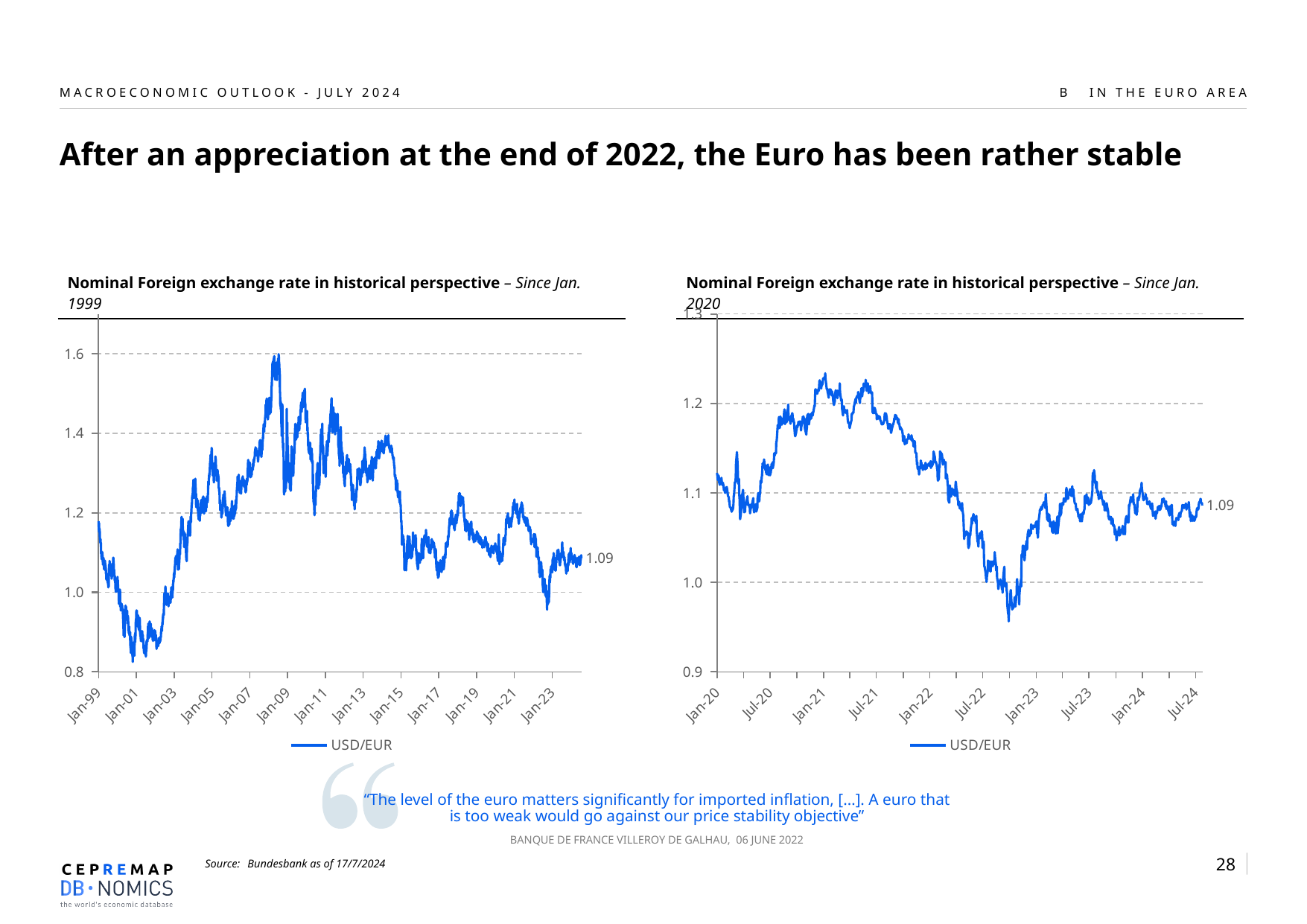
In the right chart (Since Jan. 2020), does the USD/EUR line rise or fall between Jan-21 and Jul-22? fall In the right chart (Since Jan. 2020), what is the value printed at the end of the USD/EUR line? 1.09 What series name is shown in the legend of the left chart (Since Jan. 1999)? USD/EUR In the left chart (Since Jan. 1999), is the USD/EUR value at Jan-01 greater or less than 1.0? less In the right chart (Since Jan. 2020), is the lowest point of the USD/EUR line greater or less than 1.0? less In the left chart (Since Jan. 1999), is the highest point of the USD/EUR line greater or less than 1.4? greater How many x-axis labels are shown on the right chart (Since Jan. 2020)? 10 What kind of chart is the left chart, 'Nominal Foreign exchange rate in historical perspective – Since Jan. 1999'? line chart In the left chart (Since Jan. 1999), what is the value printed at the end of the USD/EUR line? 1.09 How many series does the legend of the right chart (Since Jan. 2020) list? 1